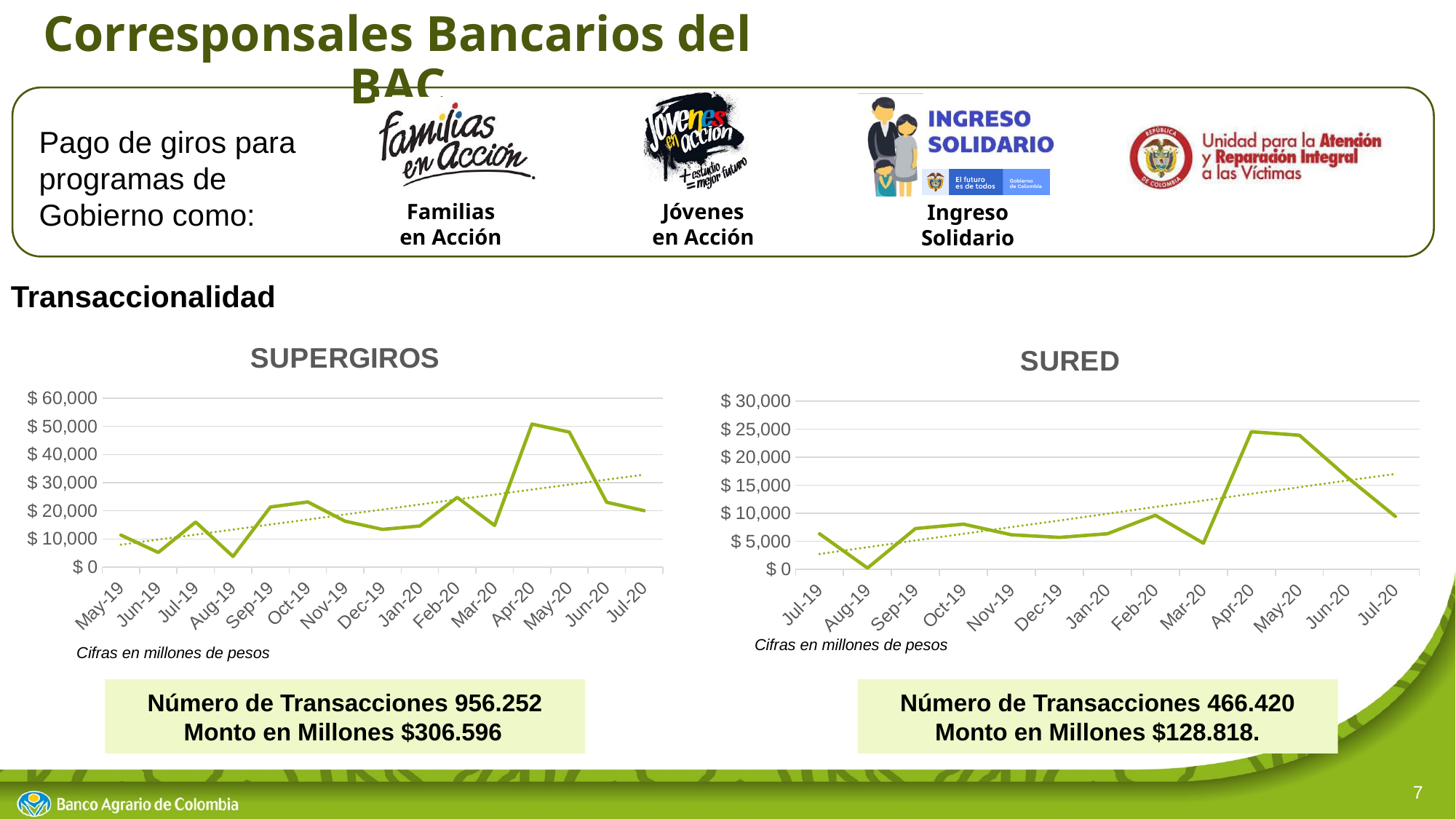
How many months are plotted on the SUPERGIROS chart? 15 On the SUPERGIROS chart, is the value for Jun-19 greater or less than $ 10,000? less What kind of chart is the SUPERGIROS chart? line chart On the SUPERGIROS chart, which month has the highest value? Apr-20 On the SURED chart, which month has the lowest value? Aug-19 On the SUPERGIROS chart, is the value for Oct-19 greater or less than $ 20,000? greater On the SURED chart, does the dotted trend line rise or fall from left to right? rise On the SURED chart, which month has the highest value? Apr-20 On the SURED chart, which is larger, the value for Apr-20 or the value for Jul-19? Apr-20 How many months are plotted on the SURED chart? 13 On the SURED chart, is the value for May-20 greater or less than $ 20,000? greater On the SUPERGIROS chart, which month has the lowest value? Aug-19